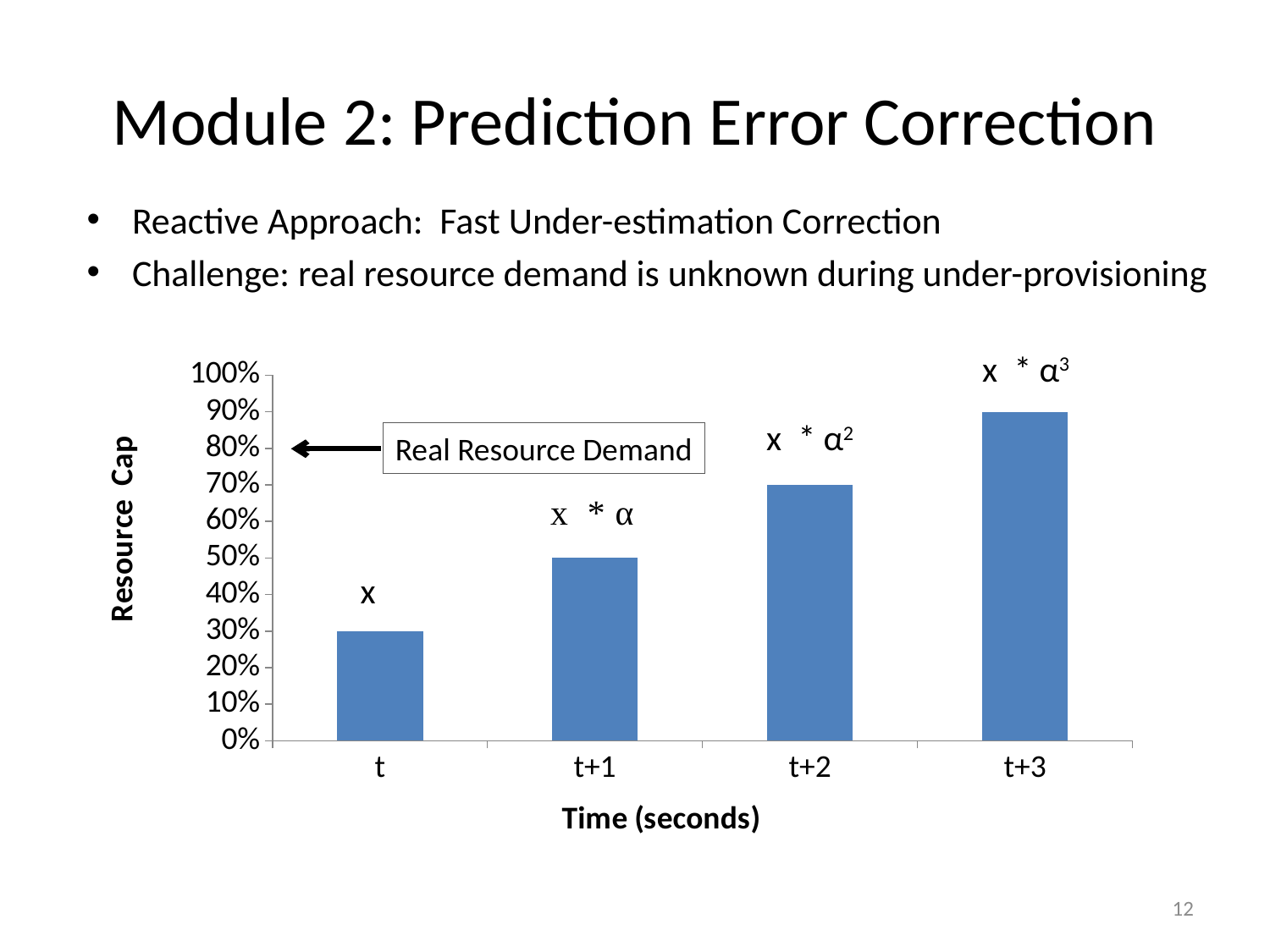
What is the title of the x axis of the chart? Time (seconds) Which time category has the highest Resource Cap? t+3 What kind of chart is shown on the slide? bar chart Which time category has the lowest Resource Cap? t What is the difference in Resource Cap between t+2 and t? 40% Is the Resource Cap for t+2 greater or less than 60%? greater Do the Resource Cap values rise or fall from t to t+3? rise What is the Resource Cap value for t? 30% What is the Resource Cap value for t+1? 50% How many time categories are shown on the x axis of the chart? 4 Which has a larger Resource Cap, t+1 or t+2? t+2 What is the Resource Cap value for t+3? 90%